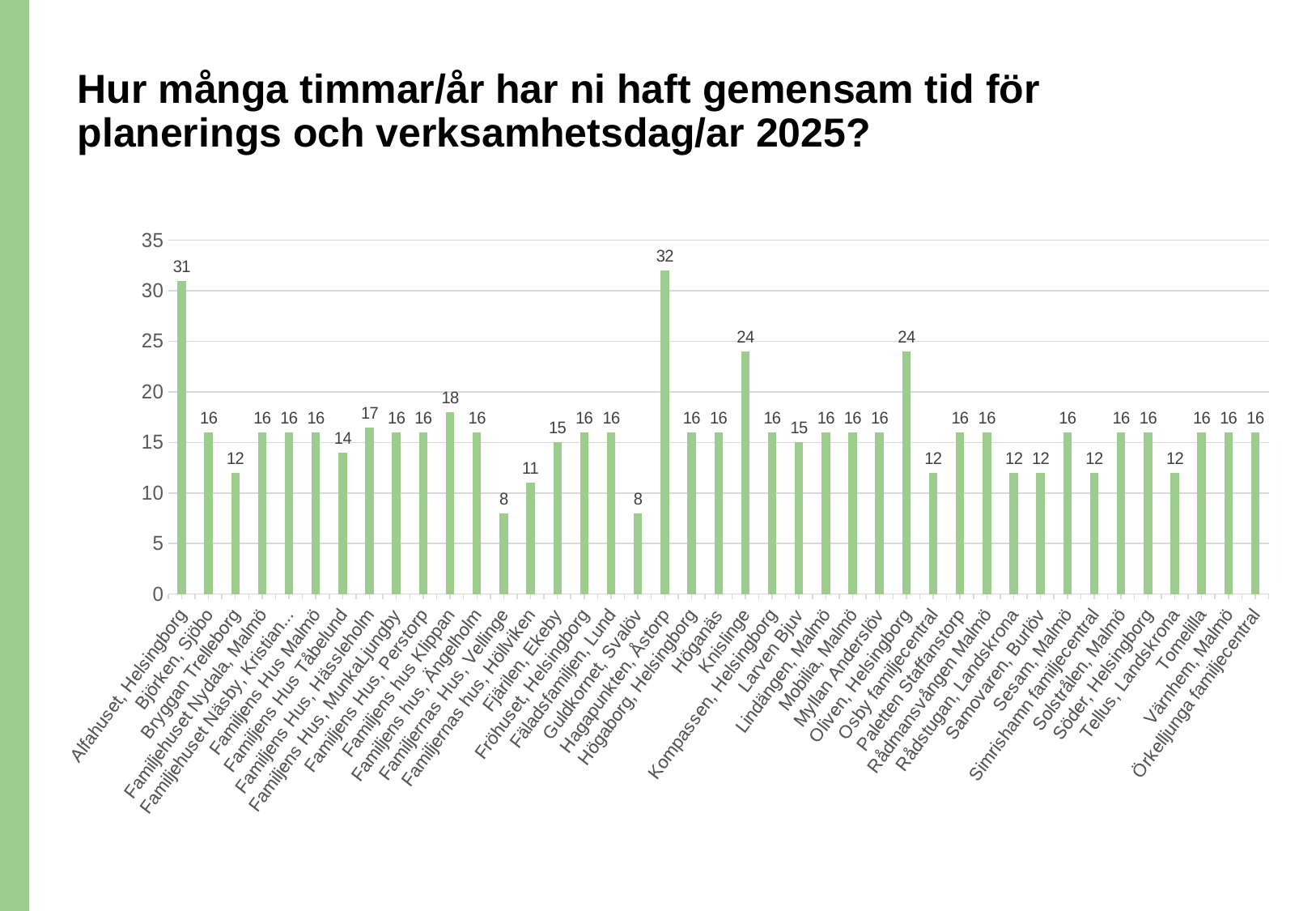
What type of chart is shown on the slide? Bar chart What is the value for Knislinge? 24 What is the value for Familjernas Hus, Höllviken? 11 What is the lowest value shown in the chart? 8 Which is larger, the value for Familjens Hus Tåbelund or the value for Familjens Hus, Hässleholm? Familjens Hus, Hässleholm What is the difference between the values for Oliven, Helsingborg and Osby familjecentral? 12 How many categories are shown on the x axis? 41 What is the value for Alfahuset, Helsingborg? 31 Is the value for Bryggan Trelleborg greater or less than 15? less Which category has the highest value? Hagapunkten, Åstorp What is the value for Familjens hus Klippan? 18